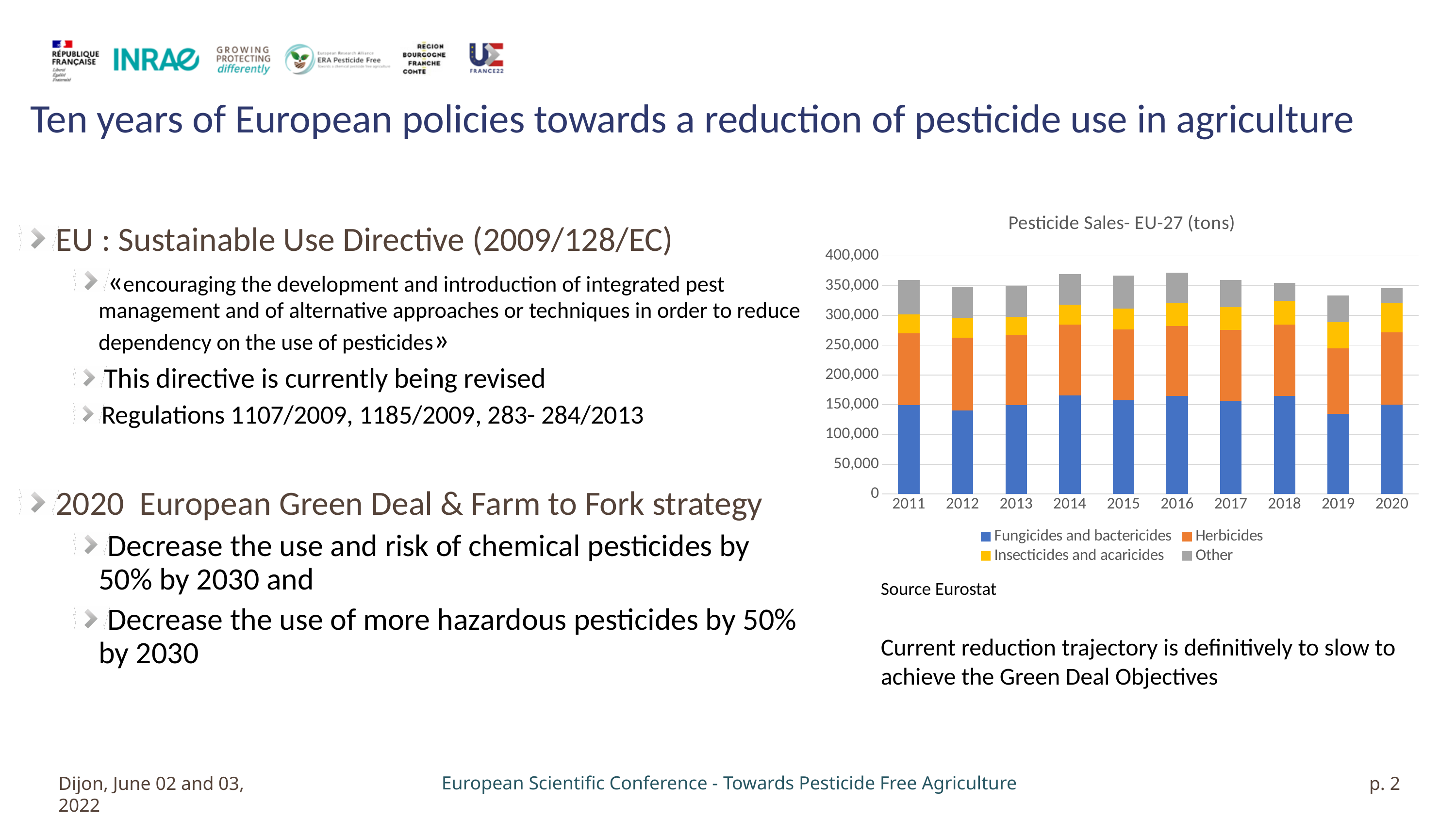
What kind of chart is shown on the slide? Stacked bar chart How many series does the chart legend list? 4 What is the title of the chart? Pesticide Sales- EU-27 (tons) Which year has the larger total pesticide sales, 2014 or 2019? 2014 Is the Fungicides and bactericides value for 2012 greater or less than 150,000? less Is the total pesticide sales value for 2014 greater or less than 350,000? greater Is the Fungicides and bactericides value for 2014 greater or less than 150,000? greater Which year has the lowest total pesticide sales in the chart? 2019 How many years are shown on the x axis of the chart? 10 Which series is shown in blue in the chart? Fungicides and bactericides Which series is larger in 2020, Fungicides and bactericides or Insecticides and acaricides? Fungicides and bactericides